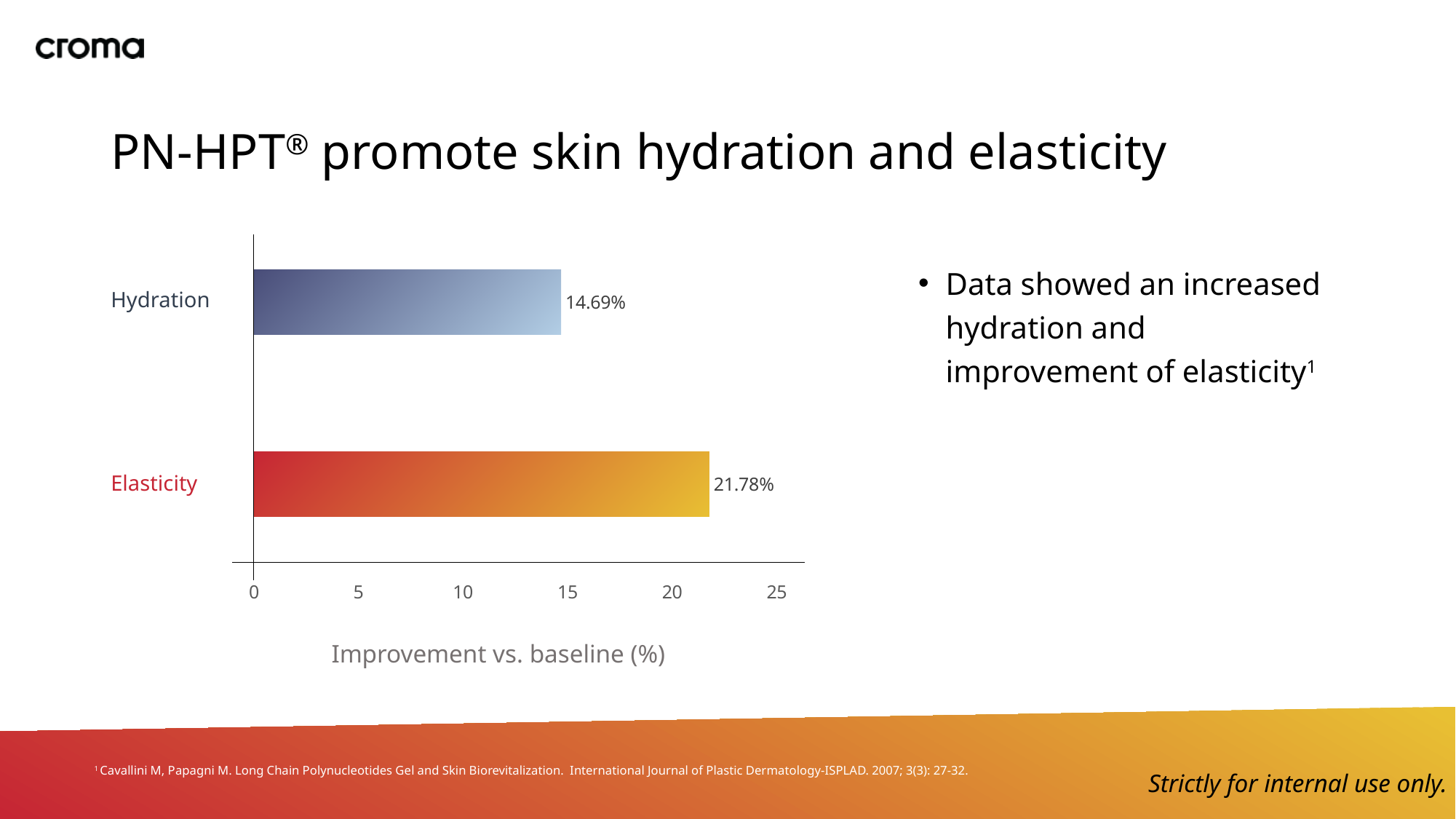
What is the difference between the Elasticity and Hydration improvement values? 7.09% Which category shows the lowest improvement vs. baseline? Hydration How many categories are plotted in the chart? 2 What is the improvement vs. baseline for Hydration? 14.69% Is the value for Hydration greater or less than 15? less What is the highest value shown on the horizontal axis of the chart? 25 What is the label of the horizontal axis of the chart? Improvement vs. baseline (%) What kind of chart is shown on the slide? Bar chart Is the value for Elasticity greater or less than 20? greater Which category shows the highest improvement vs. baseline? Elasticity What is the improvement vs. baseline for Elasticity? 21.78% Which is larger, the improvement for Hydration or for Elasticity? Elasticity